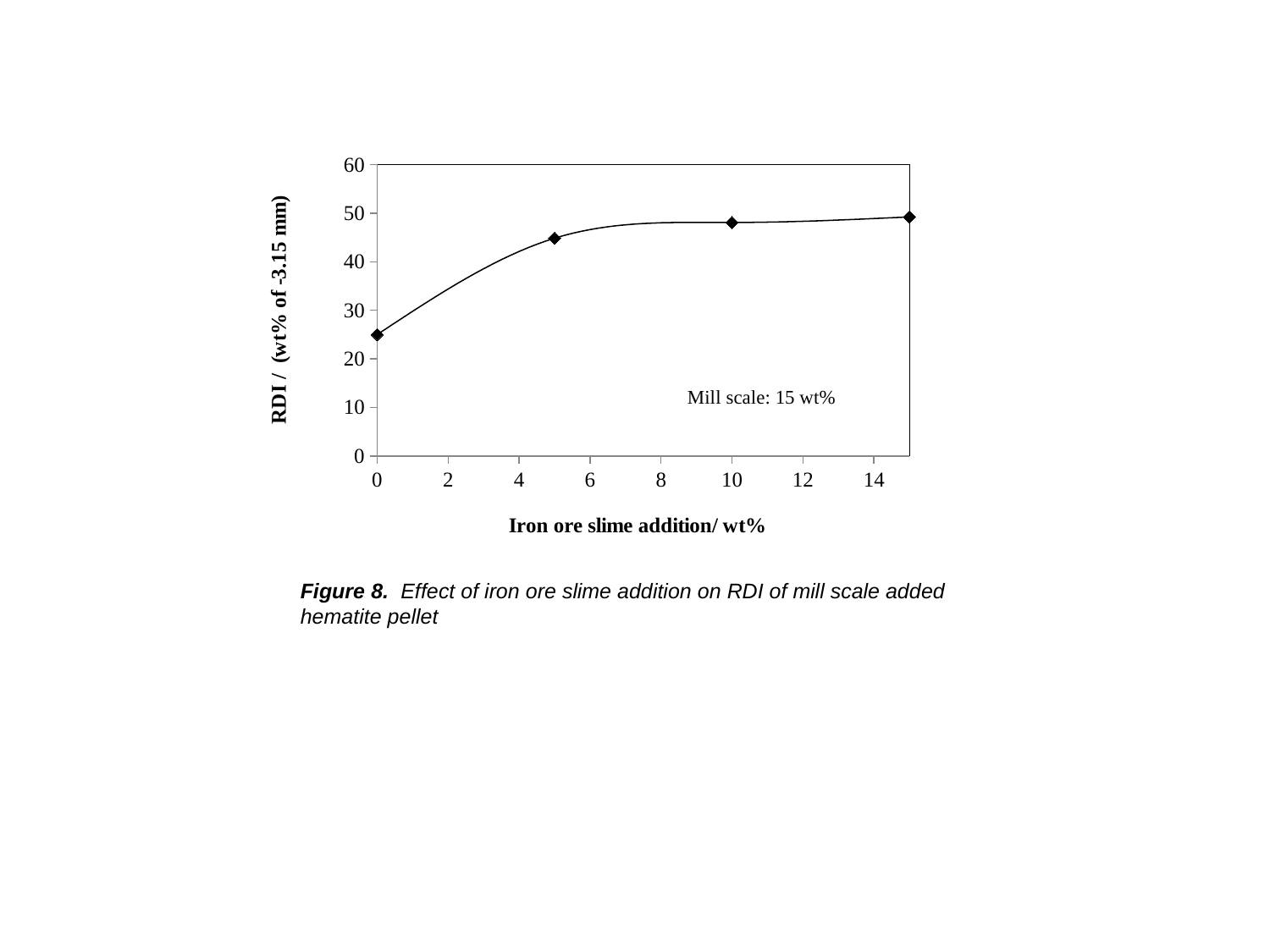
How many data points are plotted on the chart? 4 Is the RDI at 0 wt% iron ore slime addition greater or less than 30? less Is the RDI at 5 wt% iron ore slime addition greater or less than 50? less Does the RDI rise or fall as iron ore slime addition increases from 0 to 15 wt%? rises Is the RDI at 0 wt% iron ore slime addition greater or less than 20? greater What kind of chart is shown on the slide? line chart At which iron ore slime addition is the RDI lowest? 0 wt% Which has the higher RDI: 0 wt% or 5 wt% iron ore slime addition? 5 wt% What is the label of the x axis? Iron ore slime addition/ wt% What mill scale content is noted on the chart? 15 wt%